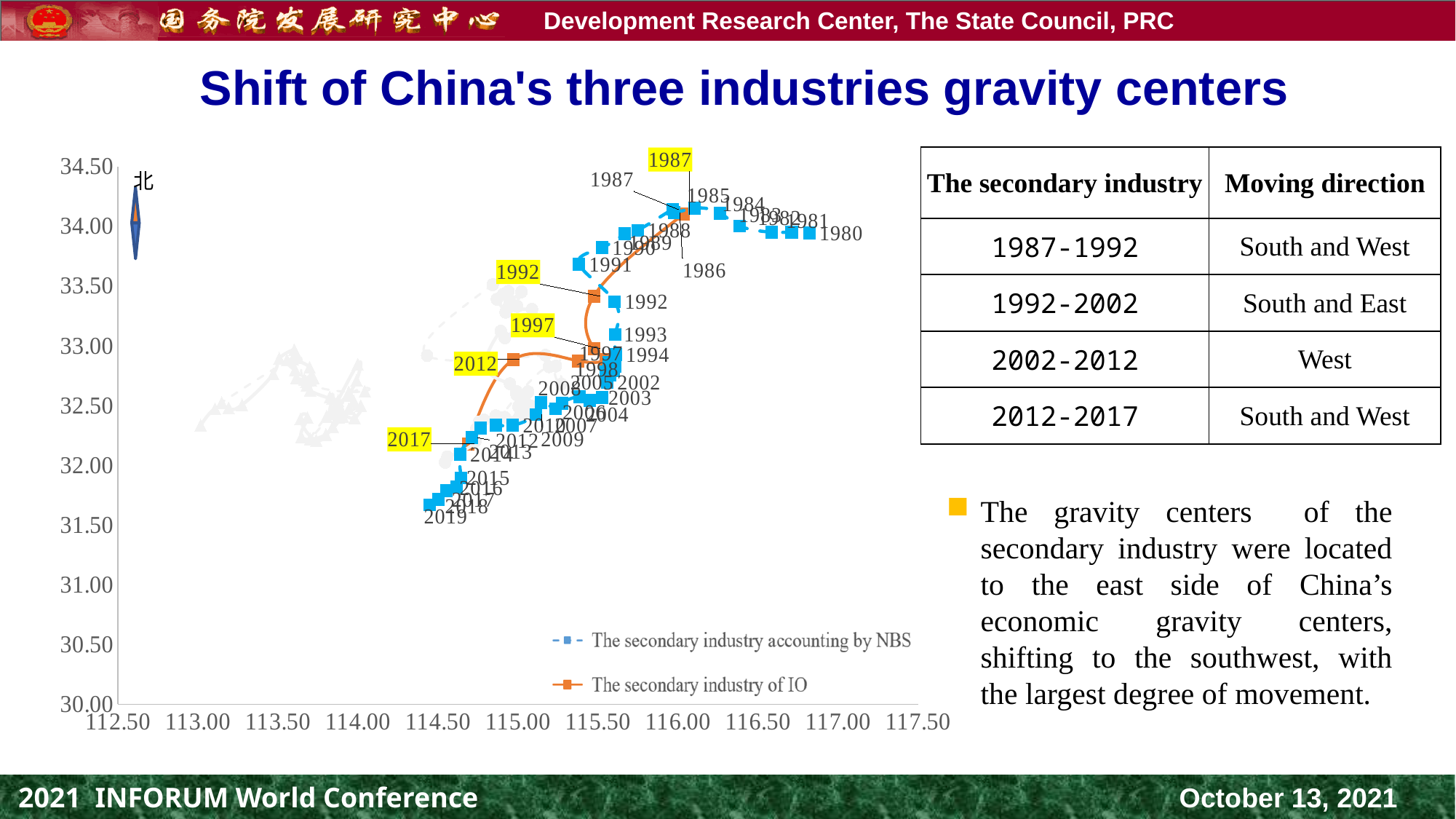
What is the name of the series drawn with the blue dashed line in the chart? The secondary industry accounting by NBS What is the name of the series drawn with the orange line in the chart? The secondary industry of IO How many series does the chart legend list? 2 Is the latitude (y-axis value) of the 1992 point on the orange IO series greater or less than 33.00? greater What kind of chart is shown on the slide? line chart Which year's point lies furthest east (highest x-axis value) in the chart? 1980 Is the longitude (x-axis value) of the 1980 point greater or less than 116.50? greater Which year's point has the lowest latitude (y-axis value) in the chart? 2019 Is the latitude (y-axis value) of the 2017 point on the orange IO series greater or less than 32.50? less Which point has the higher latitude (y-axis value), 1980 or 2019? 1980